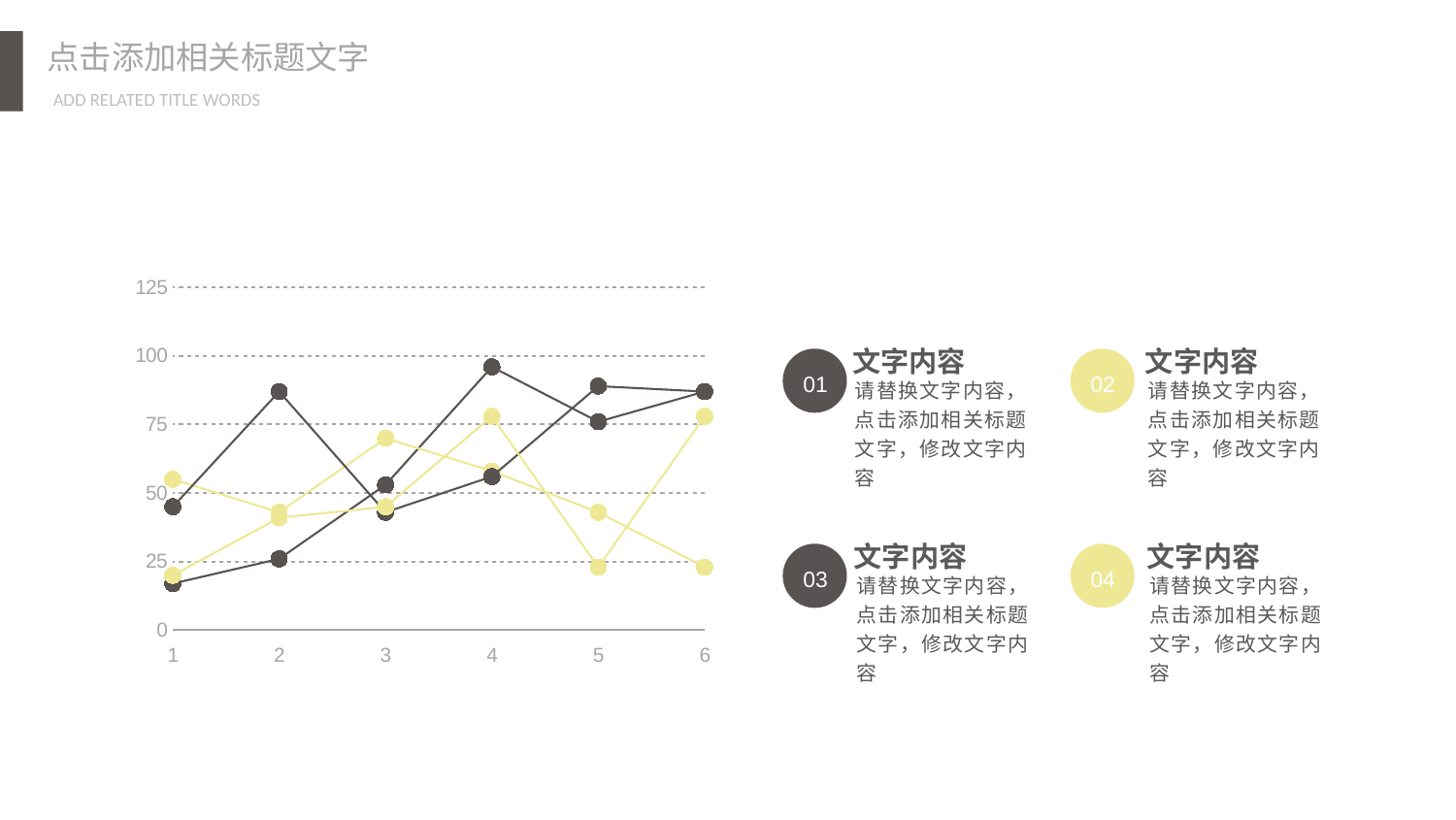
What is the highest value shown on the y axis of the chart? 125 How many points are labelled along the x axis of the chart? 6 Is the highest point plotted on the chart greater or less than 75? greater At which x-axis point does the highest value on the chart occur? 4 What is the lowest value shown on the y axis of the chart? 0 What kind of chart is shown on the slide? line chart Is the highest point plotted on the chart greater or less than 100? less Is the lowest point plotted on the chart greater or less than 25? less How many lines are plotted on the chart? 4 What two colours are used for the lines on the chart? dark grey and yellow